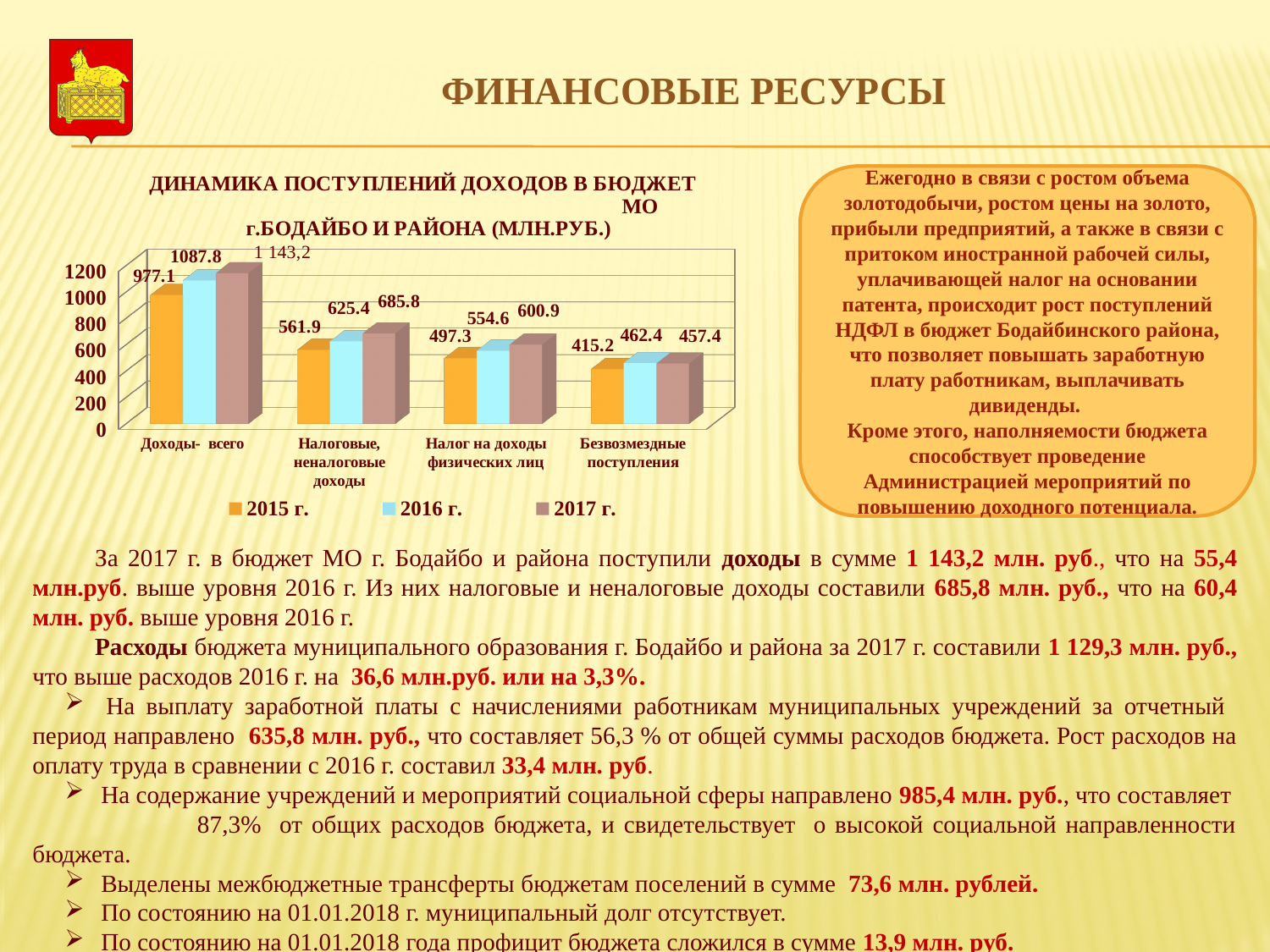
Which category has the highest value for 2017 г.? Доходы - всего What is the difference between the 2016 г. and 2015 г. values in the category 'Налоговые, неналоговые доходы'? 63.5 Do the values for 'Налог на доходы физических лиц' rise or fall from 2015 г. to 2017 г.? Rise In the category 'Безвозмездные поступления', which is larger: the value for 2016 г. or for 2017 г.? 2016 г. How many categories are shown on the x axis of the chart? 4 What is the value for 2017 г. in the category 'Безвозмездные поступления'? 457.4 How many series does the chart legend list? 3 What is the value for 2017 г. in the category 'Налоговые, неналоговые доходы'? 685.8 Which category has the lowest value for 2015 г.? Безвозмездные поступления What is the value for 2016 г. in the category 'Налог на доходы физических лиц'? 554.6 What is the value for 2015 г. in the category 'Доходы - всего'? 977.1 What type of chart is shown on the slide? Bar chart